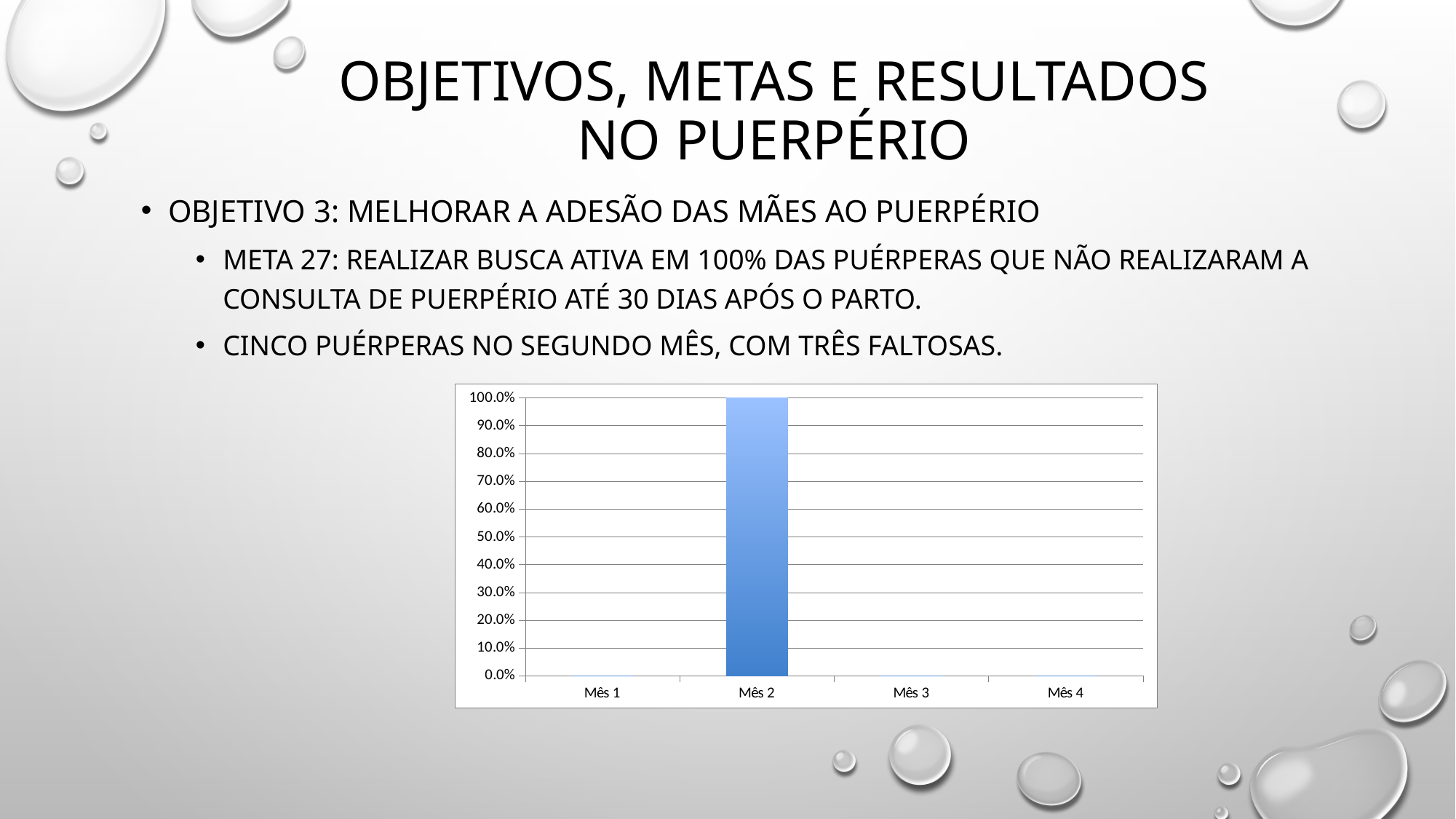
What is the value for Mês 1 in the chart? 0.0% Which is larger in the chart, the value for Mês 2 or the value for Mês 3? Mês 2 What is the value for Mês 3 in the chart? 0.0% What is the difference between the values for Mês 2 and Mês 1 in the chart? 100.0% What is the value for Mês 2 in the chart? 100.0% What is the value for Mês 4 in the chart? 0.0% Which month has the highest value in the chart? Mês 2 What kind of chart is shown on the slide? bar chart Is the value for Mês 2 greater or less than 50.0%? greater What is the label of the first category on the x axis of the chart? Mês 1 How many categories are shown on the x axis of the chart? 4 What is the highest value shown on the y axis of the chart? 100.0%